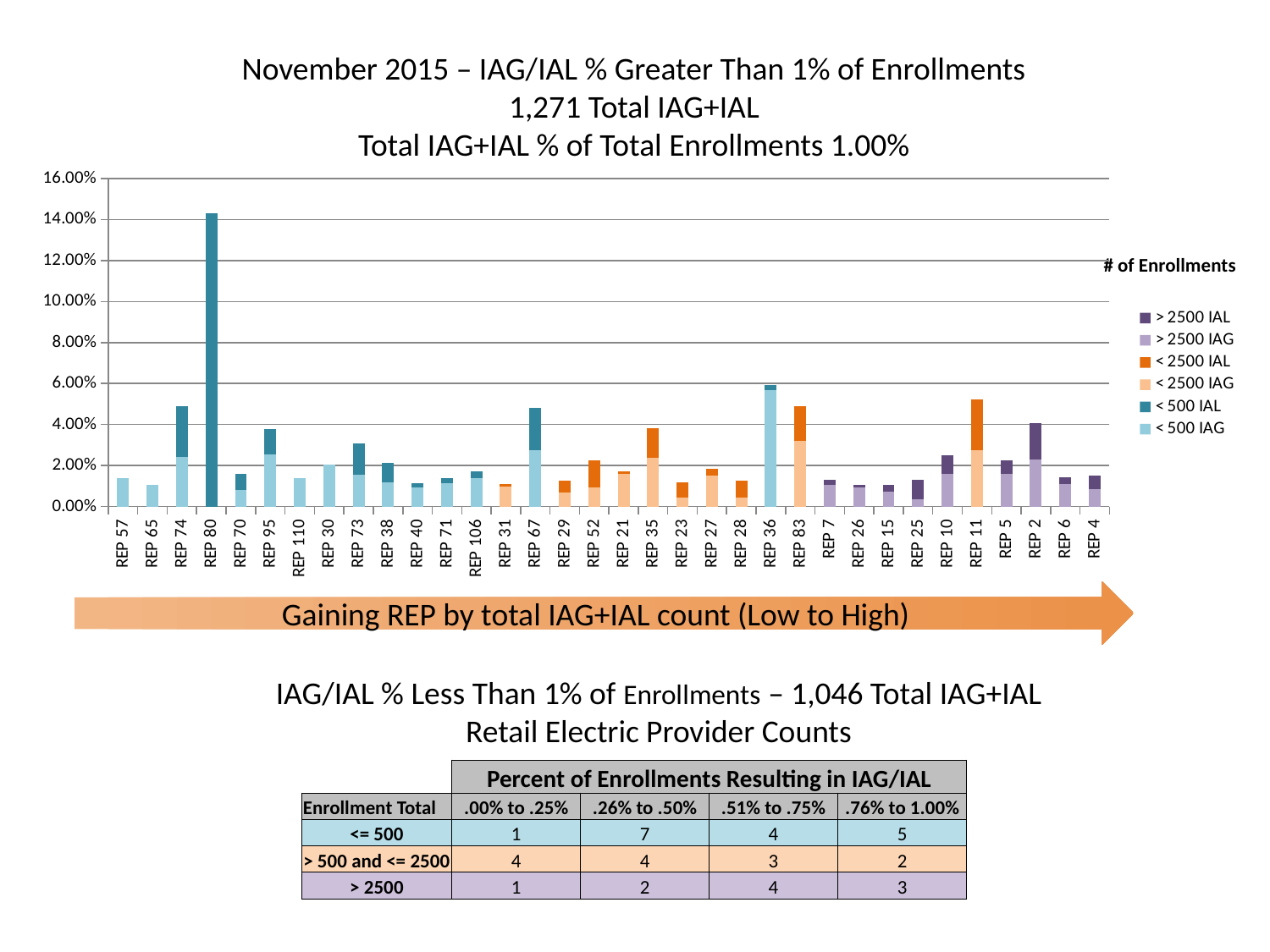
Is the value for REP 80 greater or less than 12.00%? greater What is the heading shown above the chart legend? # of Enrollments Is the value for REP 57 greater or less than 2.00%? less Is the total value for REP 36 greater or less than 4.00%? greater Which has a larger total value, REP 74 or REP 57? REP 74 How many REP categories are shown on the x axis of the chart? 34 How many series does the chart legend list? 6 Which has a larger total value, REP 80 or REP 36? REP 80 Which REP has the highest total IAG/IAL percentage in the chart? REP 80 What kind of chart is shown on the slide? Stacked bar chart